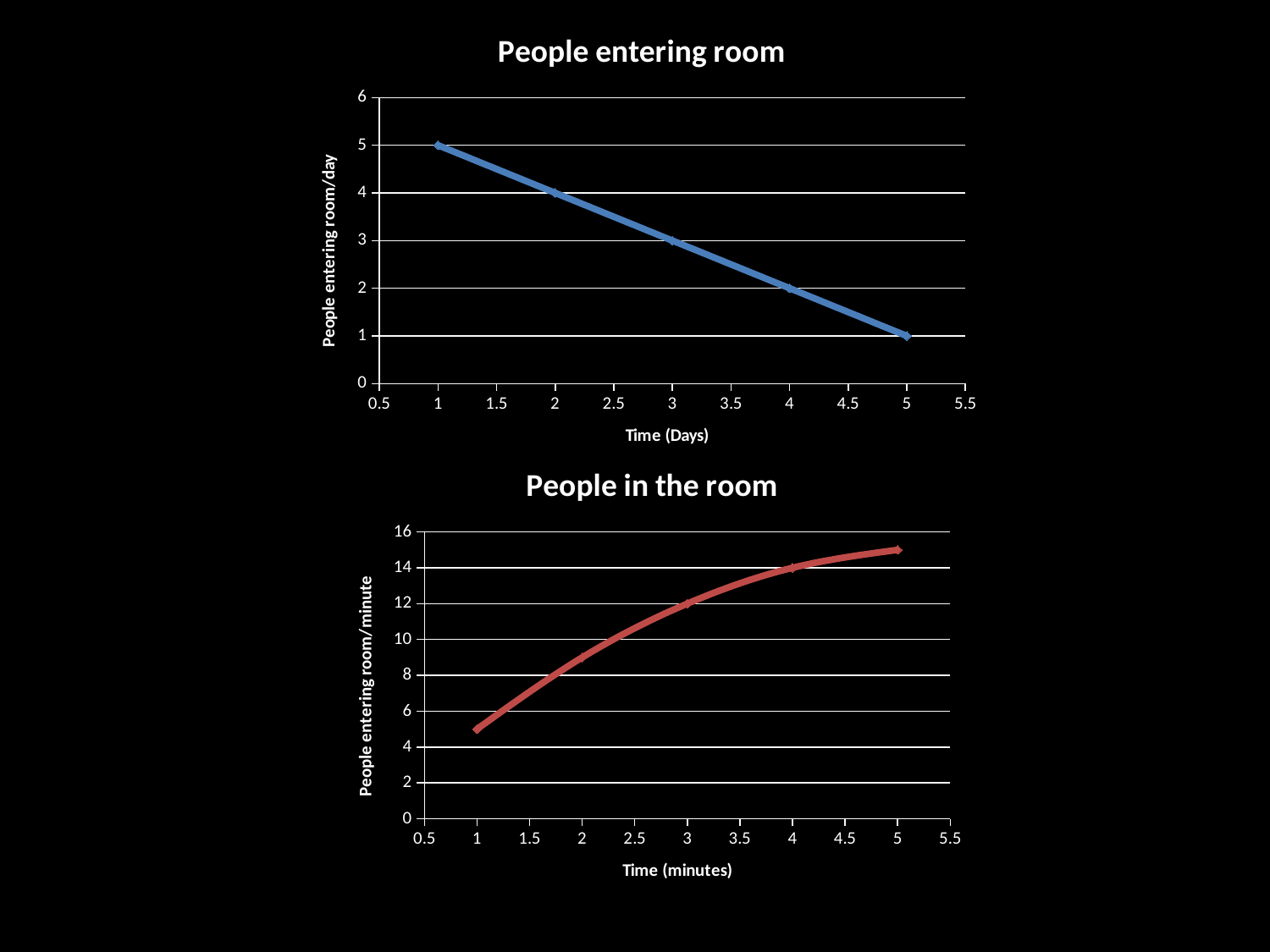
In the 'People entering room' chart, what is the value at day 5? 1 In the 'People in the room' chart, do the values rise or fall as time increases? rise In the 'People entering room' chart, what is the value at day 3? 3 In the 'People entering room' chart, do the values rise or fall as time increases? fall What kind of chart is the 'People in the room' chart? line chart In the 'People entering room' chart, how many data points are plotted? 5 In the 'People in the room' chart, is the value at minute 1 greater or less than 6? less In the 'People entering room' chart, what is the value at day 1? 5 In the 'People in the room' chart, what is the value at minute 3? 12 In the 'People in the room' chart, what is the value at minute 4? 14 In the 'People in the room' chart, is the value at minute 2 greater or less than 8? greater In the 'People entering room' chart, what is the difference between the values at day 1 and day 5? 4